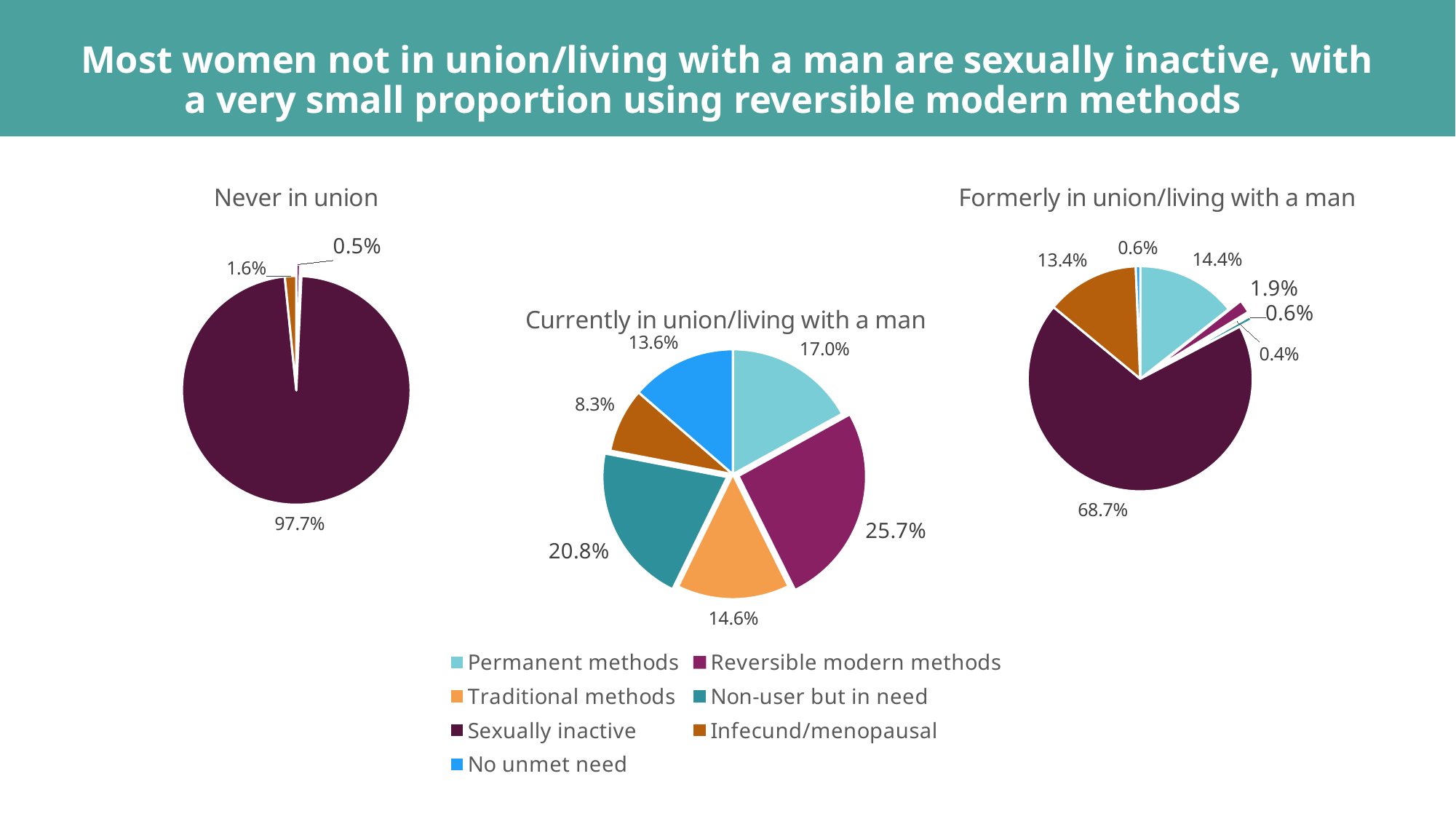
In the 'Never in union' chart, what share is Sexually inactive? 97.7% In the 'Never in union' chart, what share is Infecund/menopausal? 1.6% In the 'Currently in union/living with a man' chart, what share is Non-user but in need? 20.8% How many entries does the legend list? 7 In the 'Formerly in union/living with a man' chart, which is larger: Permanent methods or Infecund/menopausal? Permanent methods In the 'Currently in union/living with a man' chart, which category has the smallest share? Infecund/menopausal How many slices does the 'Currently in union/living with a man' pie chart have? 6 In the 'Currently in union/living with a man' chart, which category has the largest share? Reversible modern methods In the 'Currently in union/living with a man' chart, what is the difference between the Permanent methods share and the Traditional methods share? 2.4% What kind of charts are shown on the slide? Pie charts